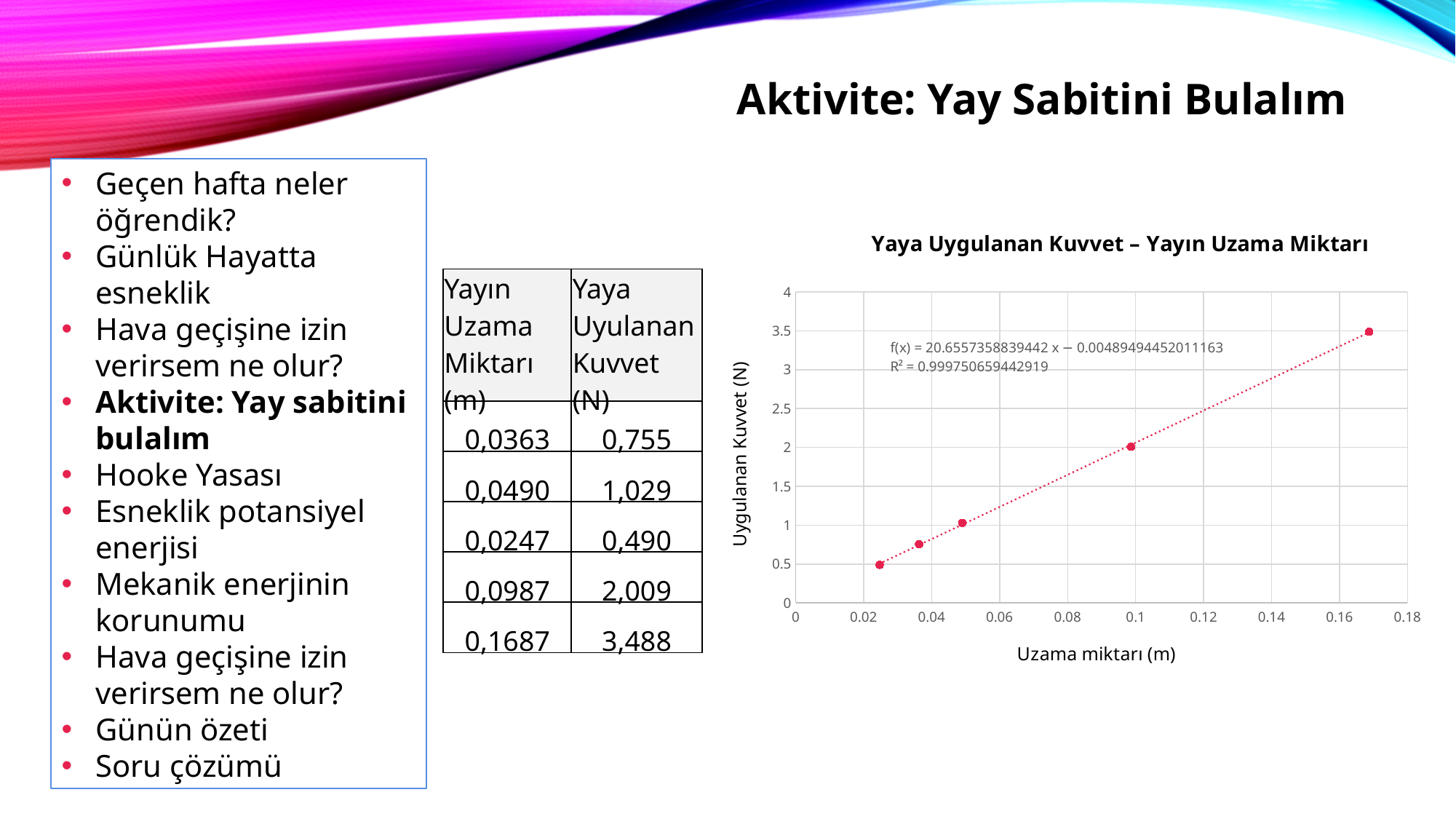
Is the force value of the rightmost data point greater or less than 3? greater What is the R² value shown on the chart's trendline? 0.999750659442919 What is the label of the y axis of the chart? Uygulanan Kuvvet (N) Is the force value of the data point near 0.05 m extension greater or less than 1.5? less Do the plotted values rise or fall as the extension (Uzama miktarı) increases along the x axis? rise How many data points are plotted on the chart? 5 What is the title of the chart? Yaya Uygulanan Kuvvet – Yayın Uzama Miktarı Is the force value of the leftmost data point greater or less than 1? less What kind of chart is shown on the slide? scatter chart